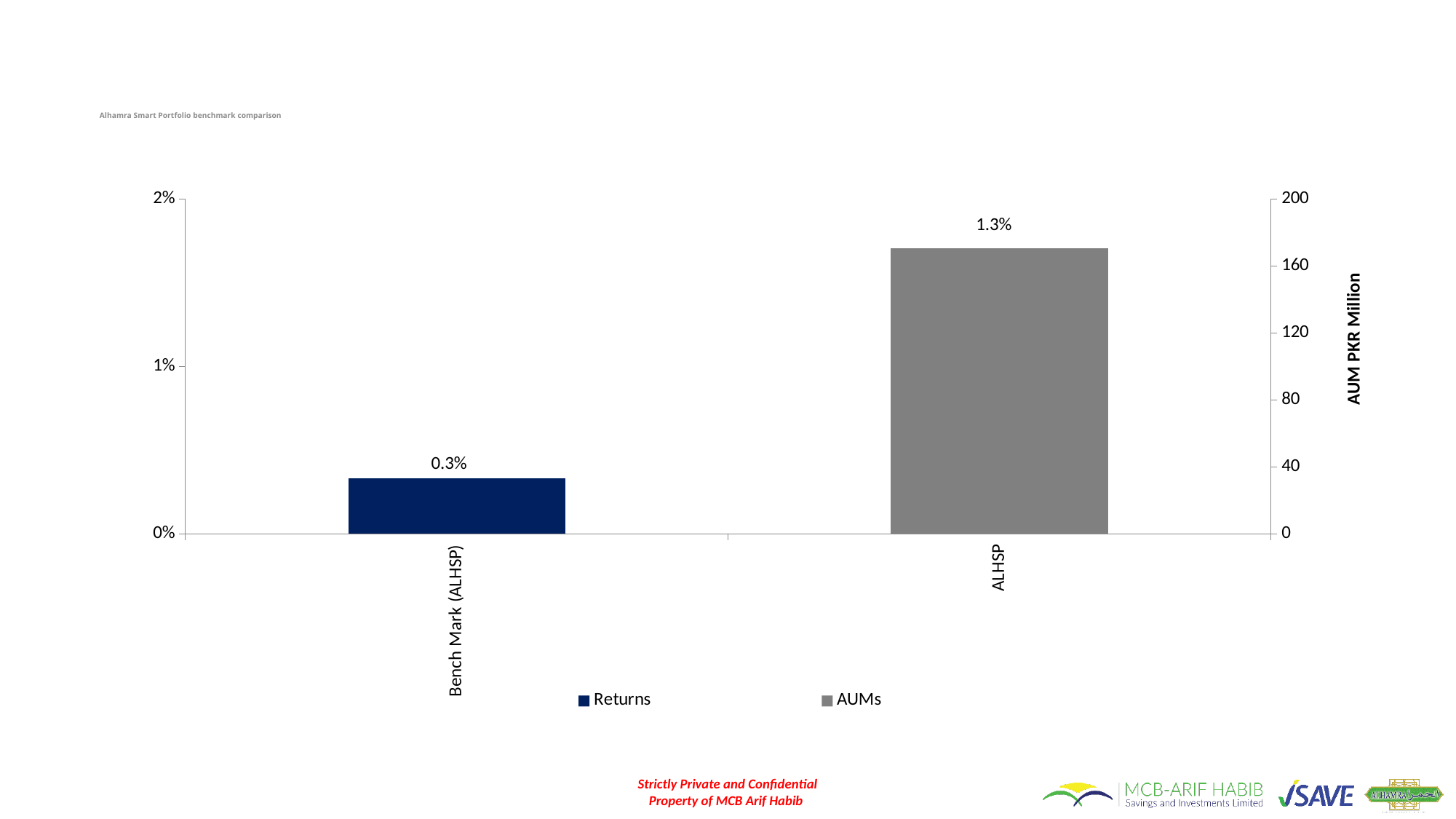
What is the data label shown on the bar for Bench Mark (ALHSP)? 0.3% How many series does the legend list? 2 Is the labelled value for ALHSP larger or smaller than the labelled value for Bench Mark (ALHSP)? larger Which category has the higher labelled value? ALHSP What kind of chart is shown on the slide? bar chart What is the title of the chart? Alhamra Smart Portfolio benchmark comparison Which category has the lower labelled value? Bench Mark (ALHSP) Is the value for Bench Mark (ALHSP) greater or less than 1% on the left axis? less What is the title of the right-hand vertical axis? AUM PKR Million What is the difference between the labelled values for ALHSP and Bench Mark (ALHSP)? 1.0% What is the data label shown on the bar for ALHSP? 1.3% How many categories are shown on the x axis? 2